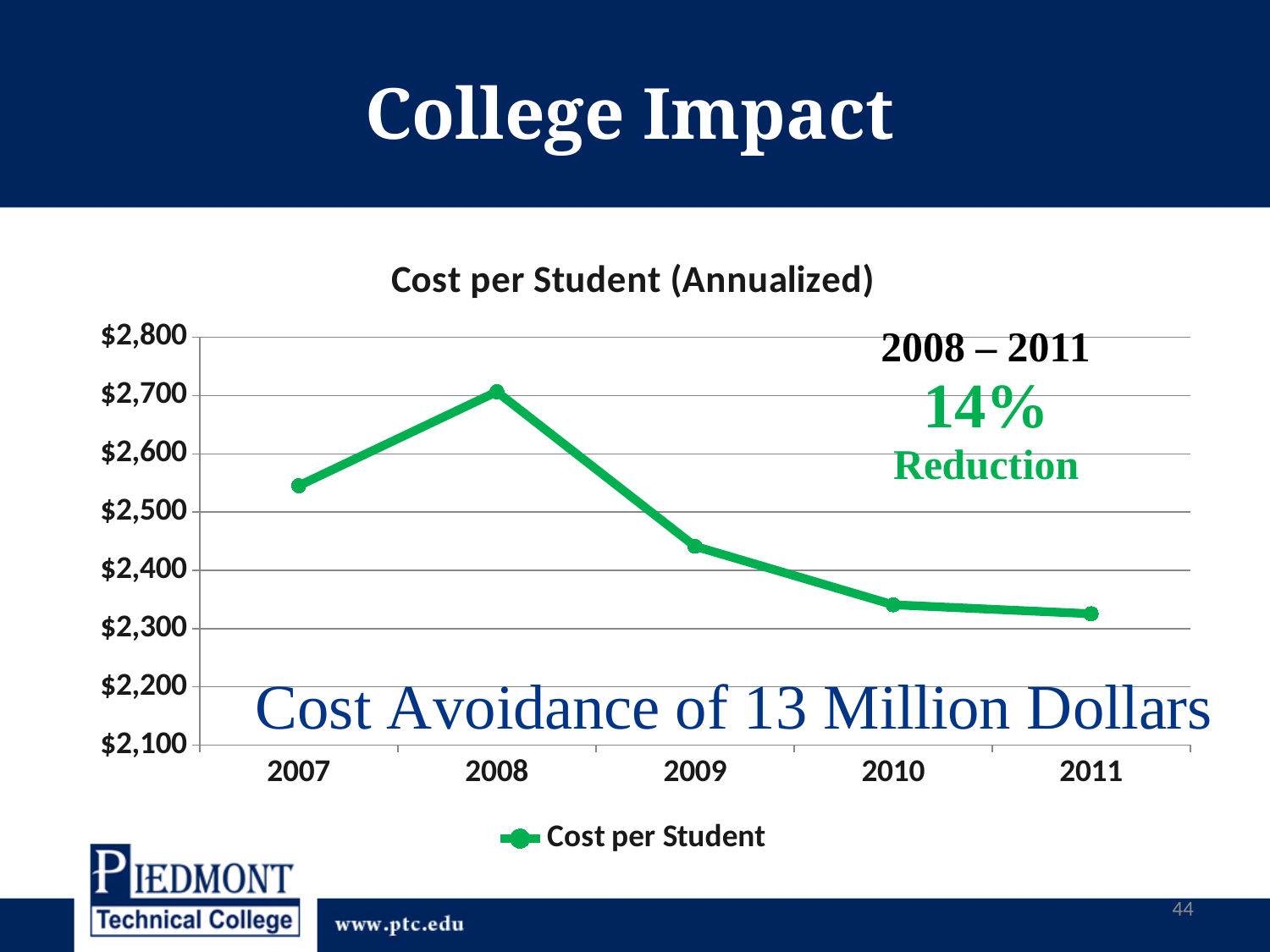
How many series does the legend list? 1 Which year has the highest cost per student? 2008 Does the cost per student rise or fall from 2008 to 2011? fall What percentage reduction from 2008 to 2011 is annotated on the chart? 14% Which year has the larger cost per student, 2007 or 2009? 2007 Is the cost per student in 2011 greater or less than $2,400? less What is the title of the chart? Cost per Student (Annualized) Is the cost per student in 2007 greater or less than $2,500? greater How many years are plotted on the x axis? 5 What kind of chart is shown on the slide? line chart Is the cost per student in 2009 greater or less than $2,500? less